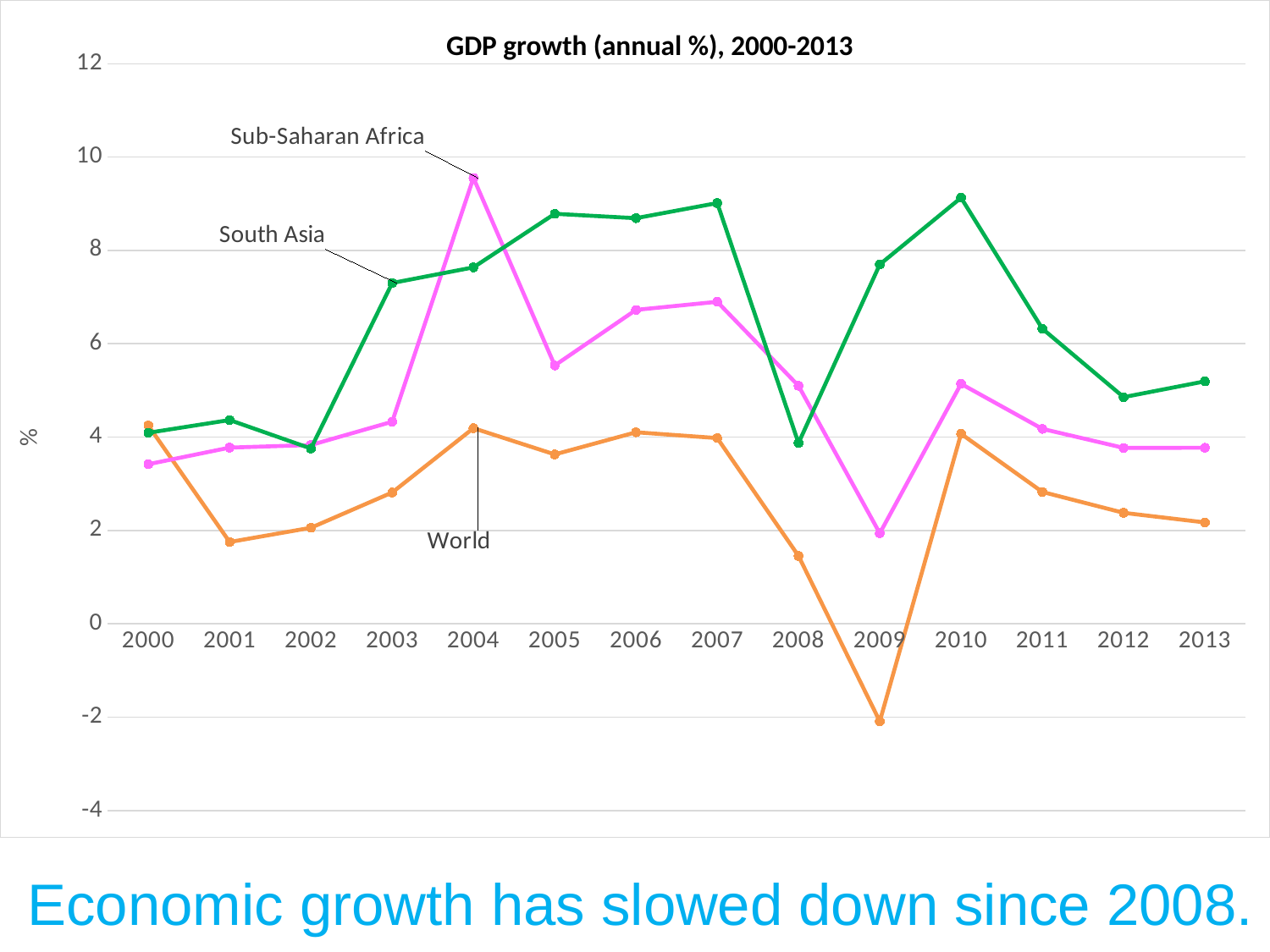
In which year does the Sub-Saharan Africa series reach its highest value? 2004 Does the South Asia series rise or fall from 2010 to 2012? fall In which year does the Sub-Saharan Africa series reach its lowest value? 2009 What is the title of the chart? GDP growth (annual %), 2000-2013 Is the value for Sub-Saharan Africa in 2004 greater or less than 8? greater What kind of chart is shown on the slide? line chart Is the value for World in 2009 greater or less than 0? less In 2008, which series has the higher value, Sub-Saharan Africa or South Asia? Sub-Saharan Africa In which year does the World series reach its lowest value? 2009 How many years are shown along the x axis? 14 Is the value for South Asia in 2010 greater or less than 8? greater How many series are plotted on the chart? 3